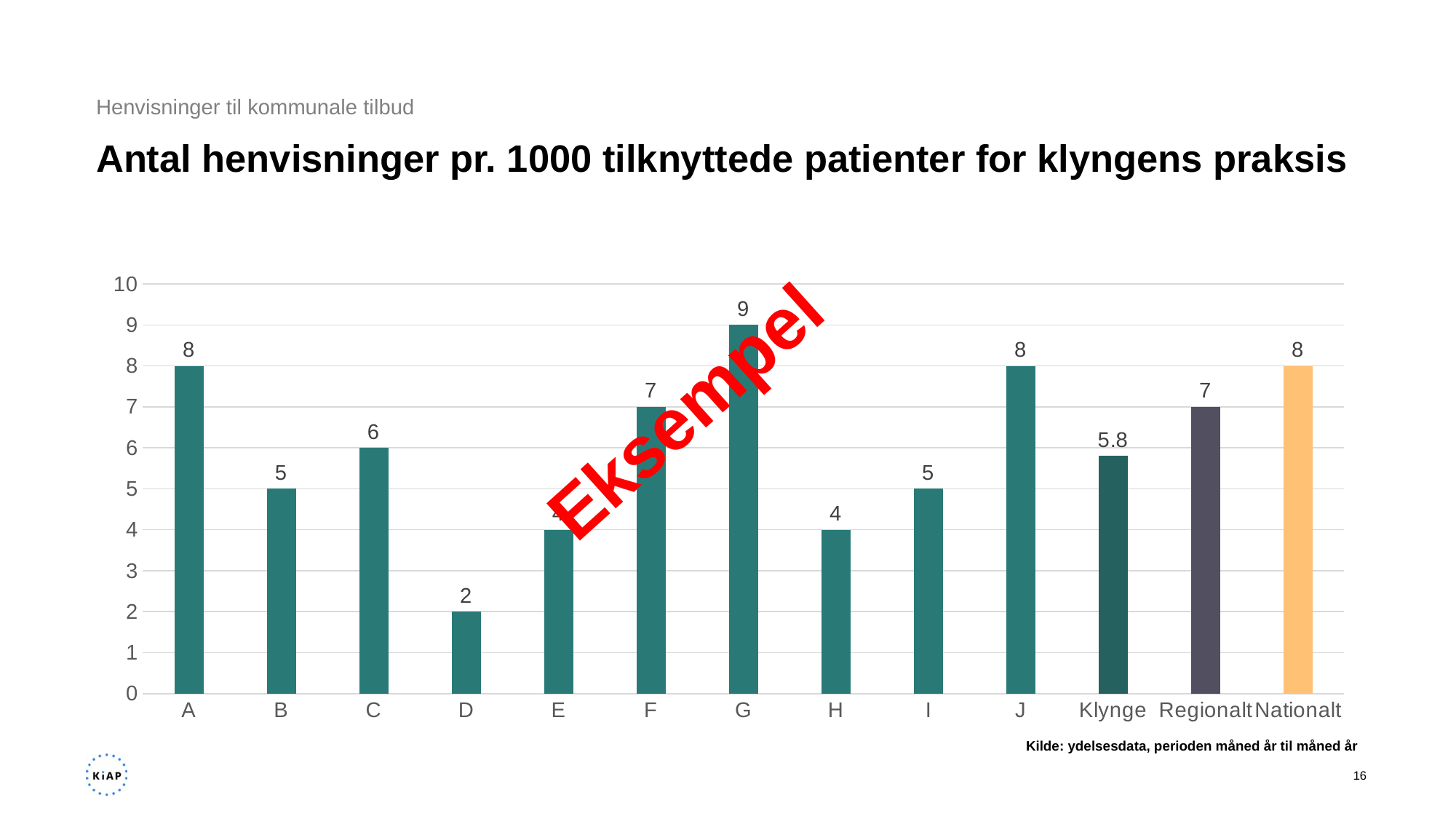
What is the value for Klynge? 5.8 Which category has the lowest value? D How many categories are shown on the x axis? 13 What is the value for G? 9 What is the title of the chart? Antal henvisninger pr. 1000 tilknyttede patienter for klyngens praksis What is the difference between the values for G and D? 7 What is the value for Regionalt? 7 What is the value for D? 2 Which category has the highest value? G What kind of chart is shown on the slide? bar chart Is the value for E greater or less than 5? less Which is larger, the value for C or the value for H? C